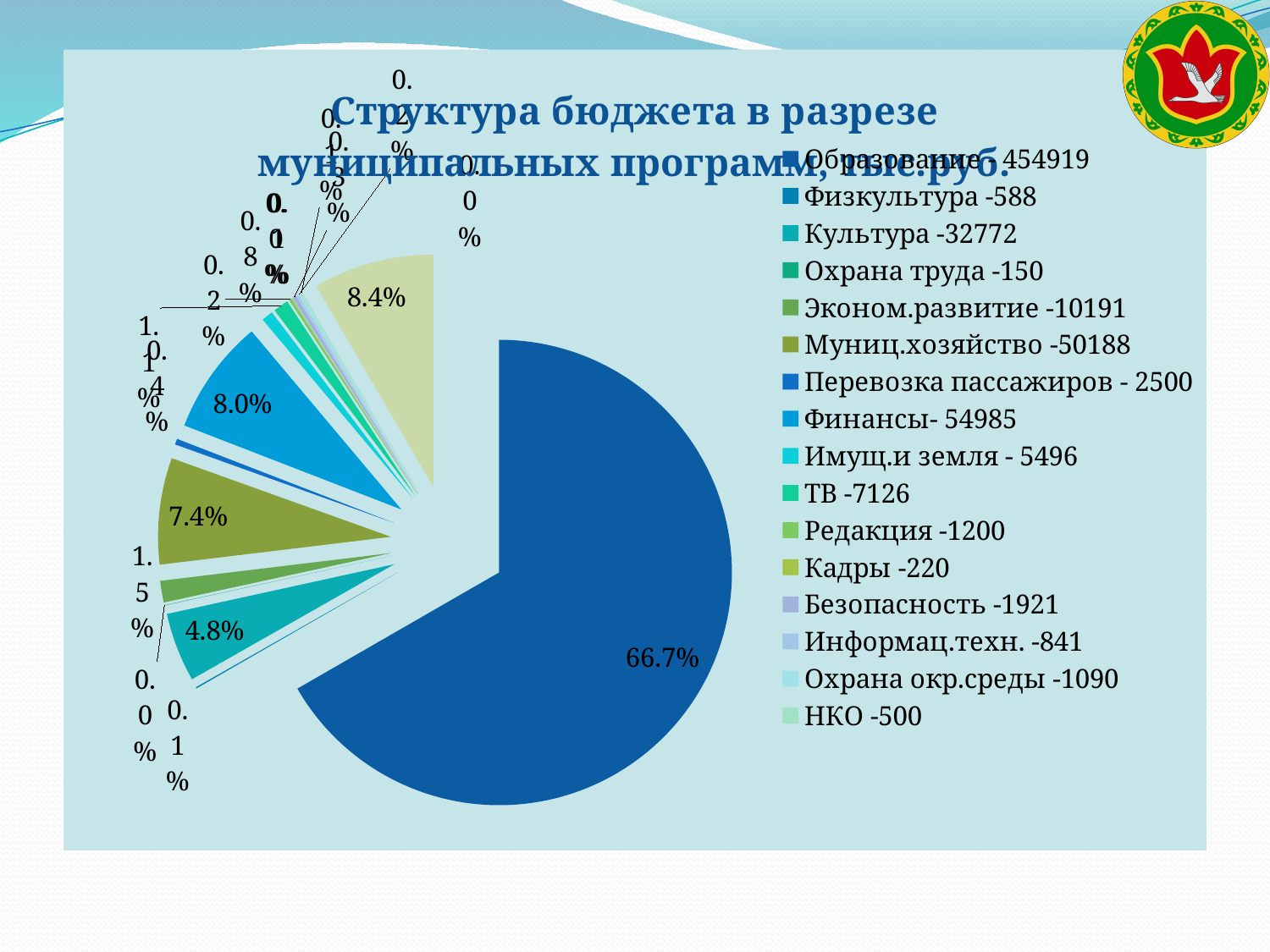
What value does the legend give for Образование? 454919 What kind of chart is shown on the slide? pie chart What percentage is labelled on the Финансы slice? 8.0% What percentage is labelled on the Культура slice? 4.8% What is the title of the chart? Структура бюджета в разрезе муниципальных программ, тыс.руб. Which category has the largest slice of the pie? Образование What share of the pie does the largest slice (Образование) take? 66.7% What is the difference in percentage points between the Образование slice (66.7%) and the Финансы slice (8.0%)? 58.7 What percentage is labelled on the Муниц.хозяйство slice? 7.4% Is the share of the Образование slice greater or less than 50%? greater How many entries does the legend list? 16 Which slice is larger, Финансы or Муниц.хозяйство? Финансы